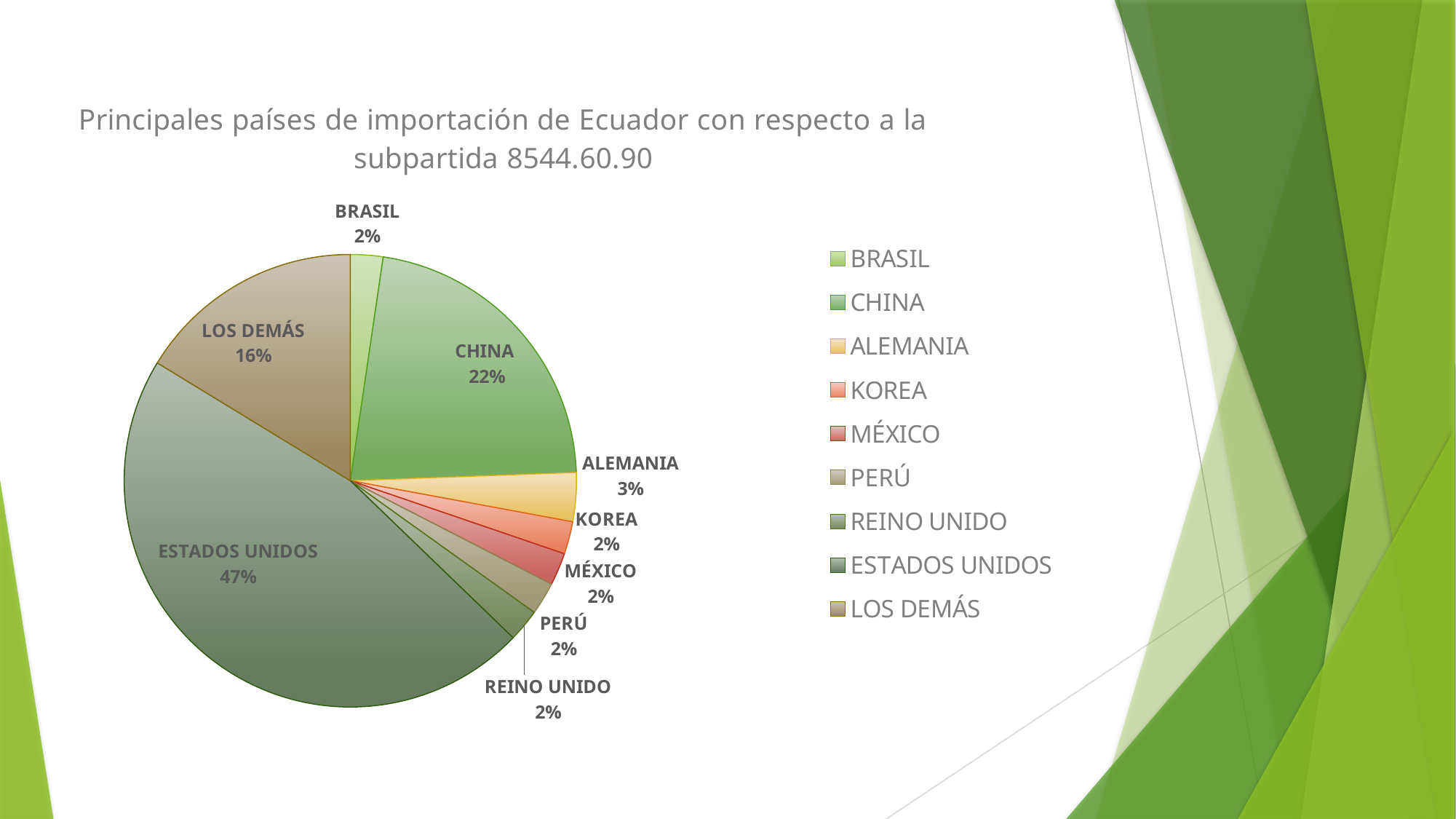
What is the difference between the shares of ESTADOS UNIDOS and CHINA? 25% What is the difference between the shares of LOS DEMÁS and ALEMANIA? 13% How many categories does the legend list? 9 What is the title of the chart? Principales países de importación de Ecuador con respecto a la subpartida 8544.60.90 Which category has the largest slice of the pie? ESTADOS UNIDOS What share of the pie does LOS DEMÁS hold? 16% What share of the pie does ESTADOS UNIDOS hold? 47% Which is larger, the share for CHINA or the share for LOS DEMÁS? CHINA What type of chart is shown on the slide? Pie chart What is the value shown for KOREA? 2% What share of the pie does ALEMANIA hold? 3%